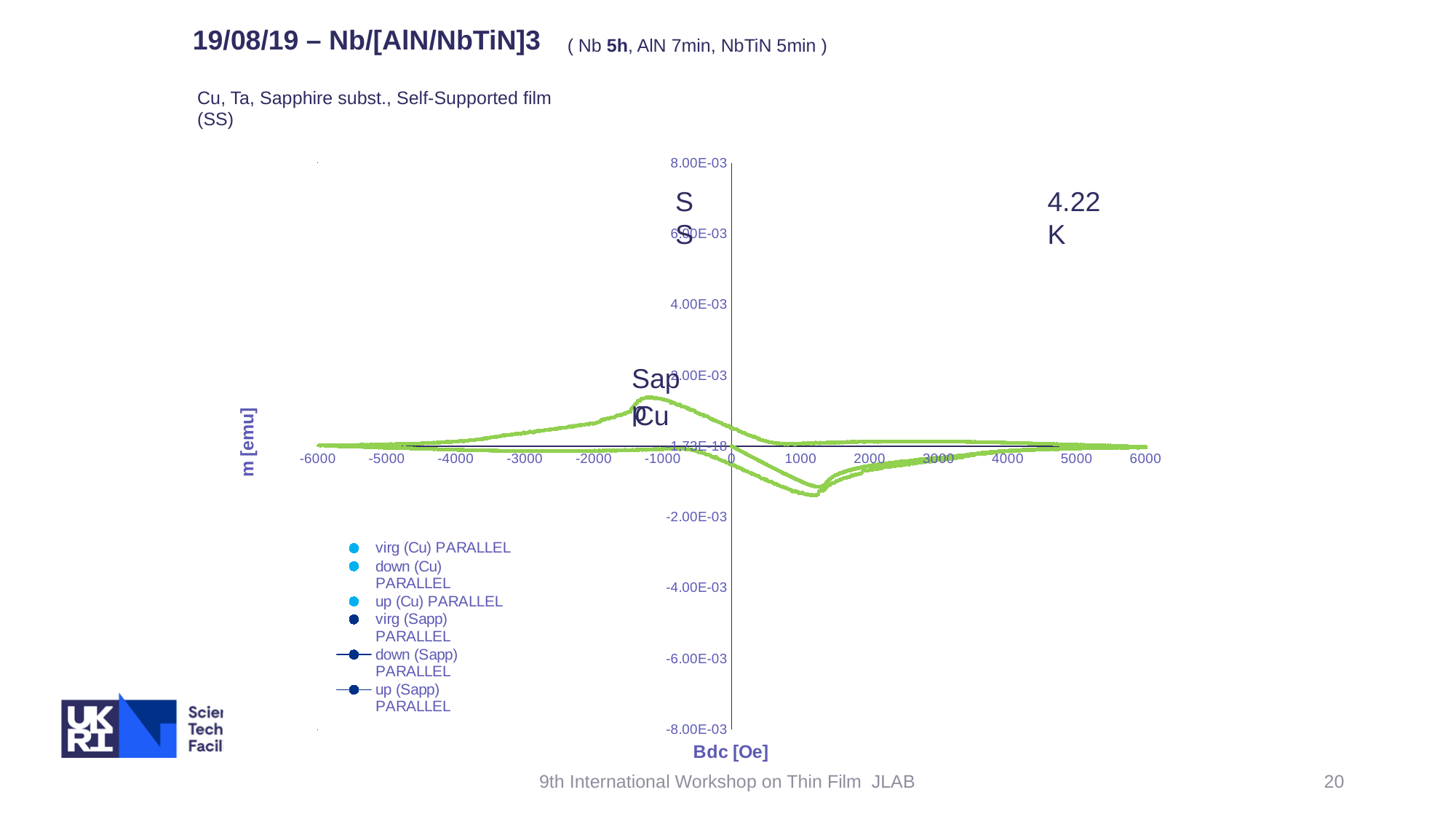
How many series does the legend list? 6 Is the lowest value of the plotted curve (near 1000 Oe) greater or less than -2.00E-03? greater What is the label of the y axis? m [emu] Is the value of the plotted curve at Bdc = -6000 Oe greater or less than -2.00E-03? greater Which legend entry is listed first? virg (Cu) PARALLEL Is the value of the plotted curve at Bdc = 6000 Oe greater or less than 2.00E-03? less What kind of chart is shown on the slide? line chart Which legend entry is listed last? up (Sapp) PARALLEL